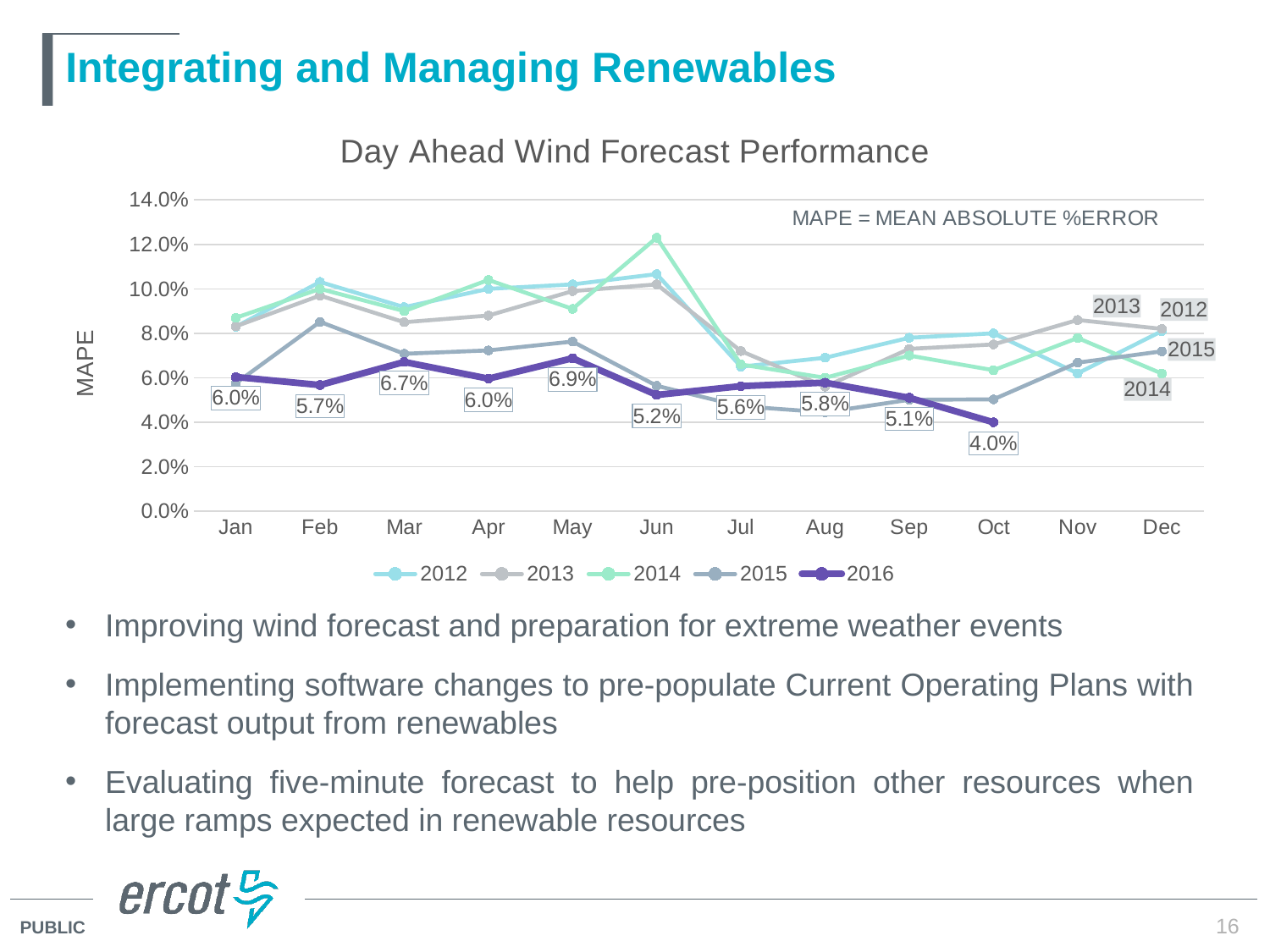
What is the 2016 value for May? 6.9% What is the 2016 value for Oct? 4.0% What kind of chart is shown? line chart Which is larger for 2016, the Mar value or the Jun value? Mar What is the difference between the 2016 values for May and Oct? 2.9% In which month is the 2016 series highest? May Does the 2016 series rise or fall from Aug to Oct? fall How many series does the legend list? 5 Is the 2014 value for Jun greater or less than 10.0%? greater In which month is the 2016 series lowest? Oct How many months are shown on the x axis? 12 What is the 2016 value for Feb? 5.7%